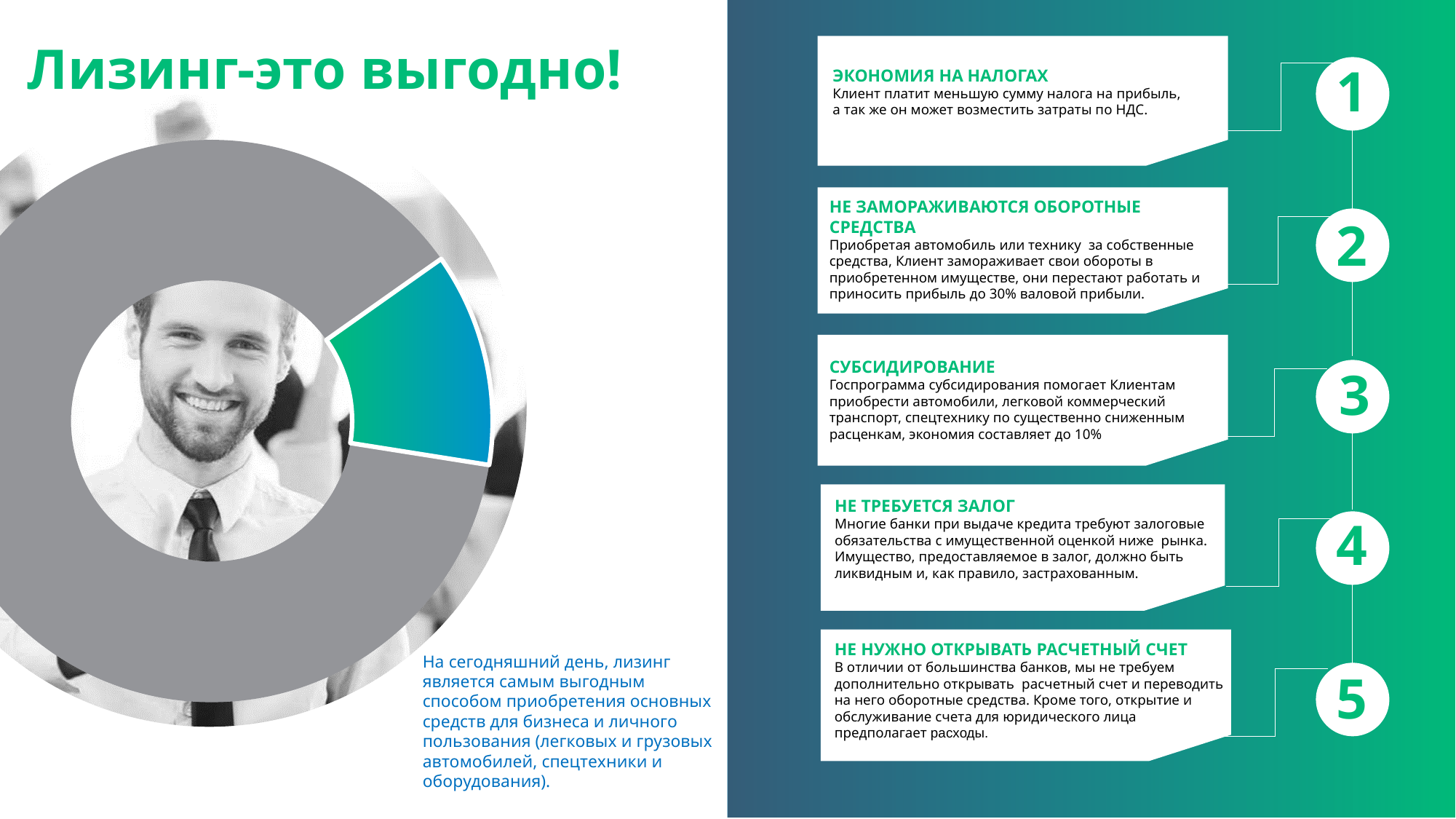
Which slice of the doughnut chart is larger, the gray one or the teal-green one? The gray one What is shown in the centre hole of the doughnut chart? A photo of a smiling man Does the doughnut chart display any data labels with values? No Which slice of the doughnut chart is the largest? The gray slice What kind of chart is shown on the left side of the slide? Doughnut chart Which slice of the doughnut chart is the smallest? The teal-green slice How many slices does the doughnut chart on the left contain? 2